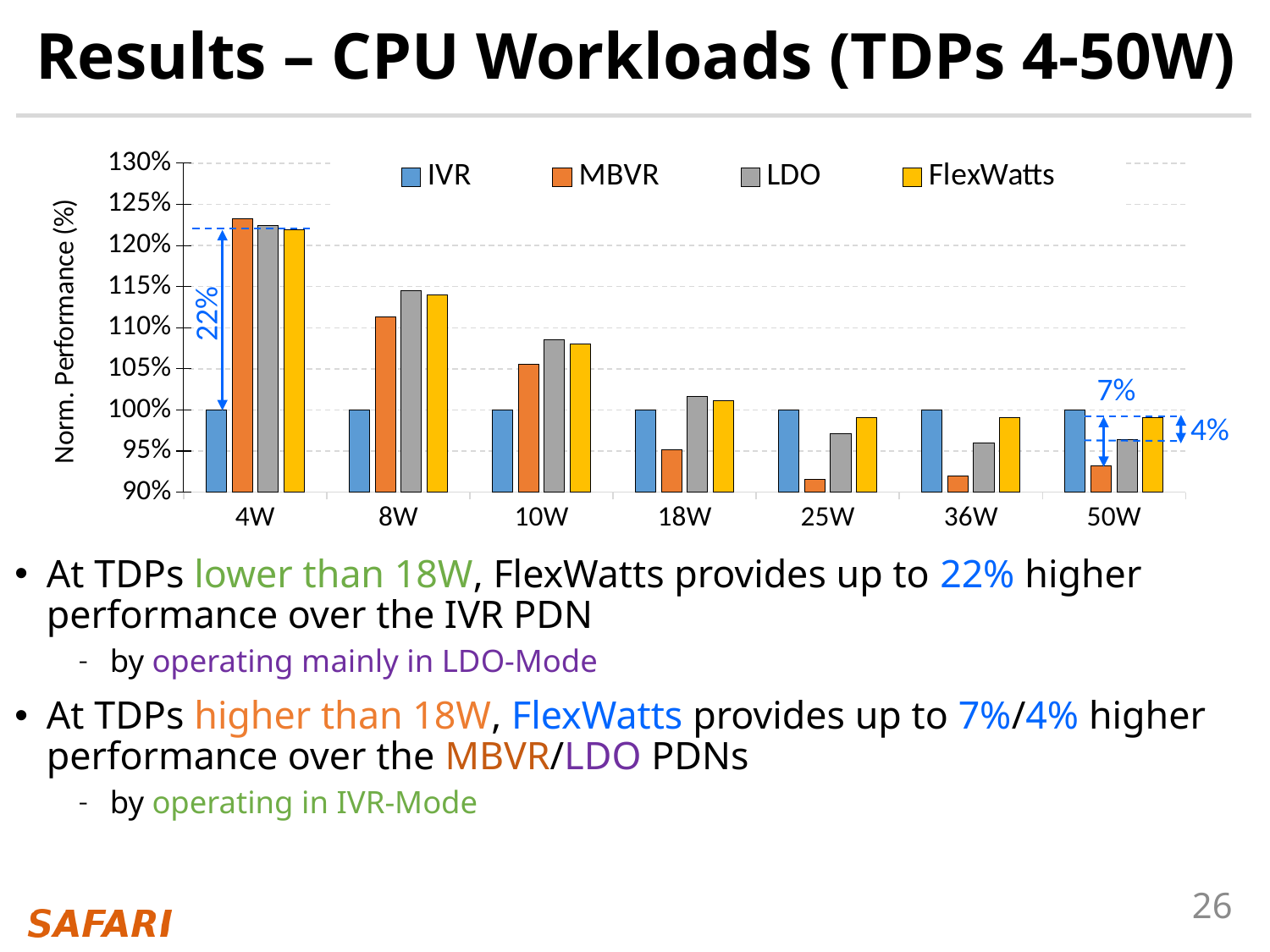
At 10W, which is larger: the MBVR value or the LDO value? LDO Is the value for FlexWatts at 10W greater or less than 105%? greater Do the FlexWatts values generally rise or fall as TDP increases from 4W to 50W? fall What kind of chart is shown on the slide? bar chart At which TDP is the MBVR bar the highest? 4W What is the label on the y axis of the chart? Norm. Performance (%) Which series has the lowest bar at 25W? MBVR What is the normalized performance of IVR at 4W? 100% How many TDP categories are shown on the x axis of the chart? 7 Is the value for MBVR at 25W greater or less than 95%? less Is the value for MBVR at 4W greater or less than 120%? greater How many series does the chart's legend list? 4